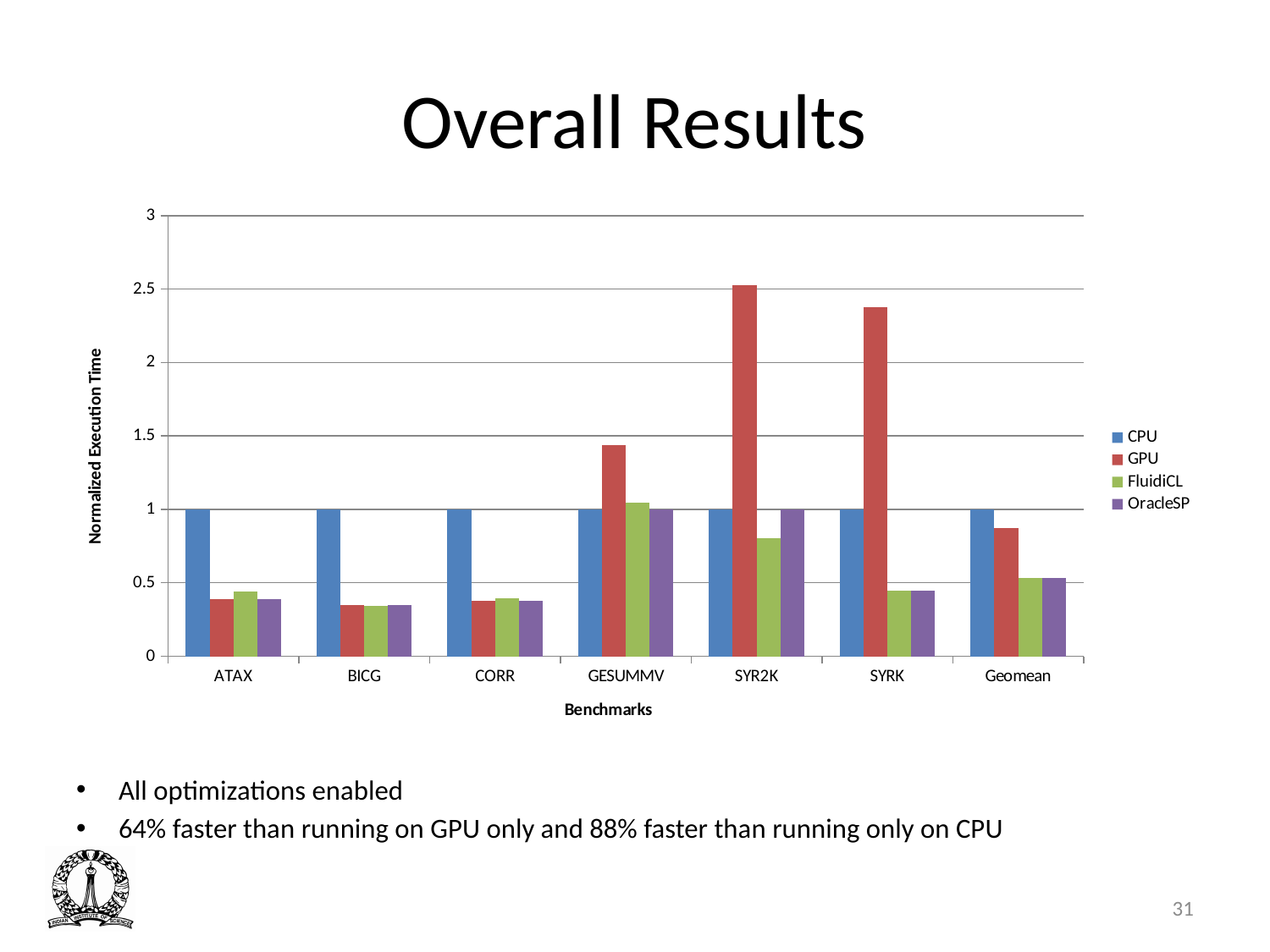
How many benchmark categories are shown on the x axis? 7 Is the GPU value for SYR2K greater or less than 2? greater Is the FluidiCL value for BICG greater or less than 0.5? less For SYR2K, which is larger: the FluidiCL value or the OracleSP value? OracleSP For GESUMMV, which is larger: the GPU value or the FluidiCL value? GPU Is the GPU value for Geomean greater or less than 1? less What is the title of the y axis? Normalized Execution Time What is the CPU value for ATAX? 1 What kind of chart is shown on the slide? bar chart Which benchmark has the highest GPU value? SYR2K How many series does the legend list? 4 What is the title of the x axis? Benchmarks